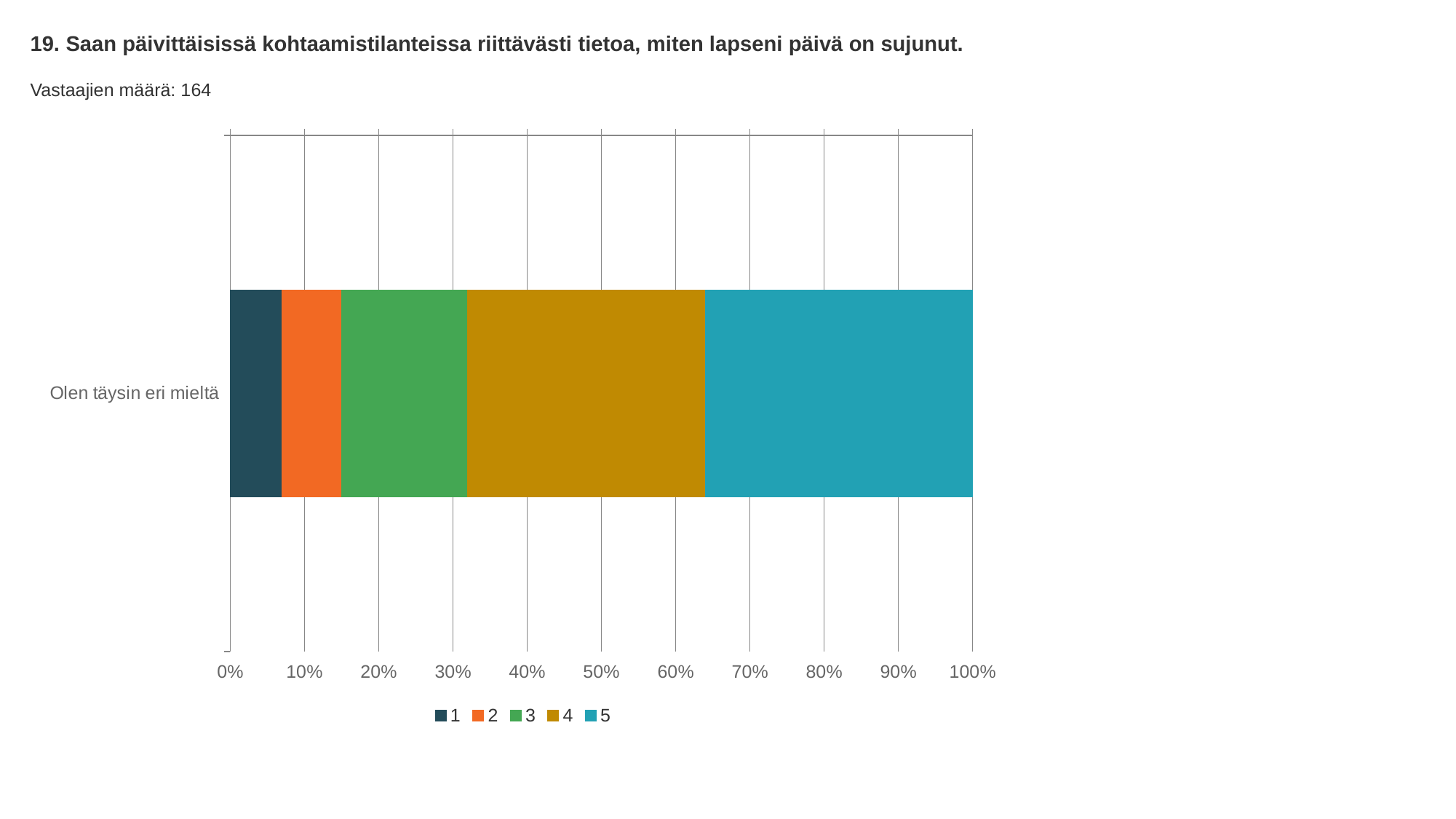
Which series takes up the largest share of the bar? 5 Is the value for series 3 greater or less than 20%? less Is the value for series 1 greater or less than 10%? less What value does the full stacked bar reach on the x axis? 100% Which is larger, the segment for series 4 or the segment for series 3? 4 Is the value for series 5 greater or less than 30%? greater What is the label of the category shown on the y axis? Olen täysin eri mieltä How many series does the legend list? 5 What kind of chart is shown on the slide? Stacked bar chart How many respondents (Vastaajien määrä) are reported on the slide? 164 Which is larger, the segment for series 3 or the segment for series 1? 3 How many categories are plotted on the y axis? 1